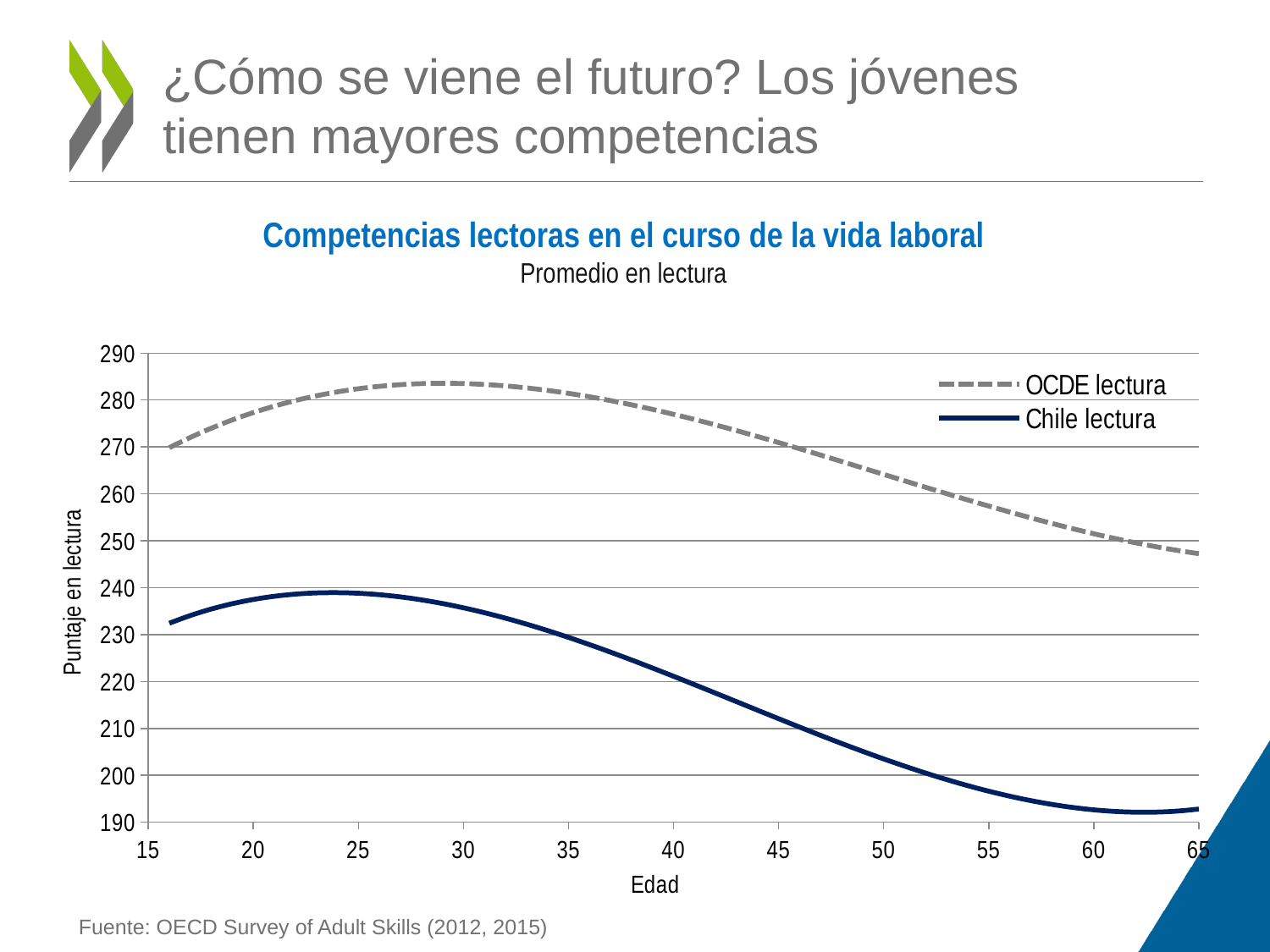
What is the title of the chart? Competencias lectoras en el curso de la vida laboral Is the value for Chile lectura at age 30 greater or less than 240? less Does the Chile lectura line rise or fall between age 30 and age 60? fall What kind of chart is shown on the slide? line chart Is the value for Chile lectura at age 45 greater or less than 220? less At age 40, which series has the higher value, OCDE lectura or Chile lectura? OCDE lectura Is the value for Chile lectura at age 60 greater or less than 200? less What is the label of the y axis? Puntaje en lectura How many series does the legend list? 2